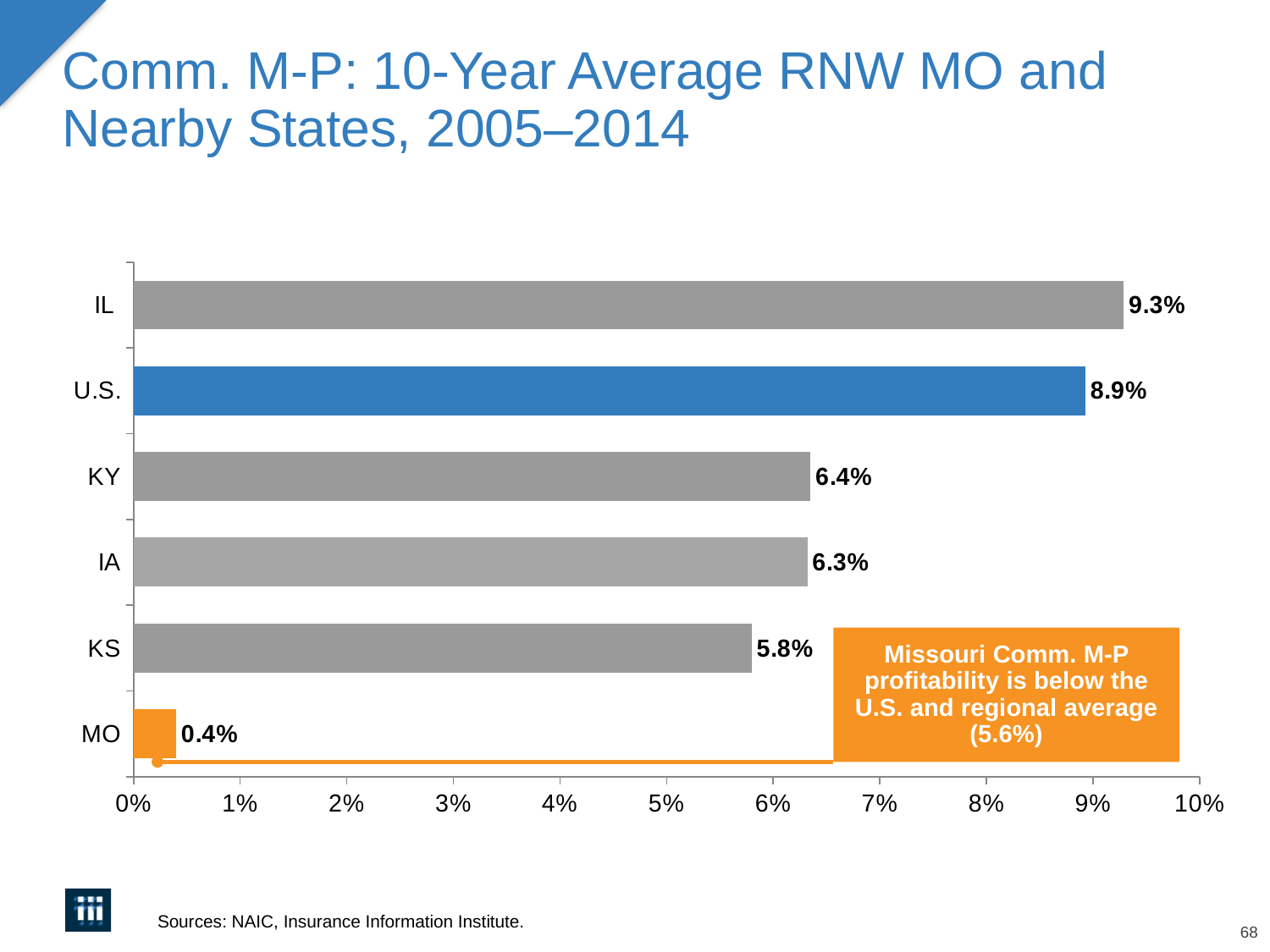
What is the 10-year average RNW for IL? 9.3% According to the callout box, what is the regional average Missouri is compared against? 5.6% What kind of chart is shown on the slide? Bar chart What is the 10-year average RNW for MO? 0.4% What is the difference between the KS value and the MO value? 5.4% Which bar is coloured blue? U.S. What is the difference between the IL value and the U.S. value? 0.4% How many categories are shown on the chart? 6 Which category has the highest 10-year average RNW? IL Which category has the lowest 10-year average RNW? MO Which is larger, the value for KY or the value for KS? KY What is the value shown for the U.S.? 8.9%